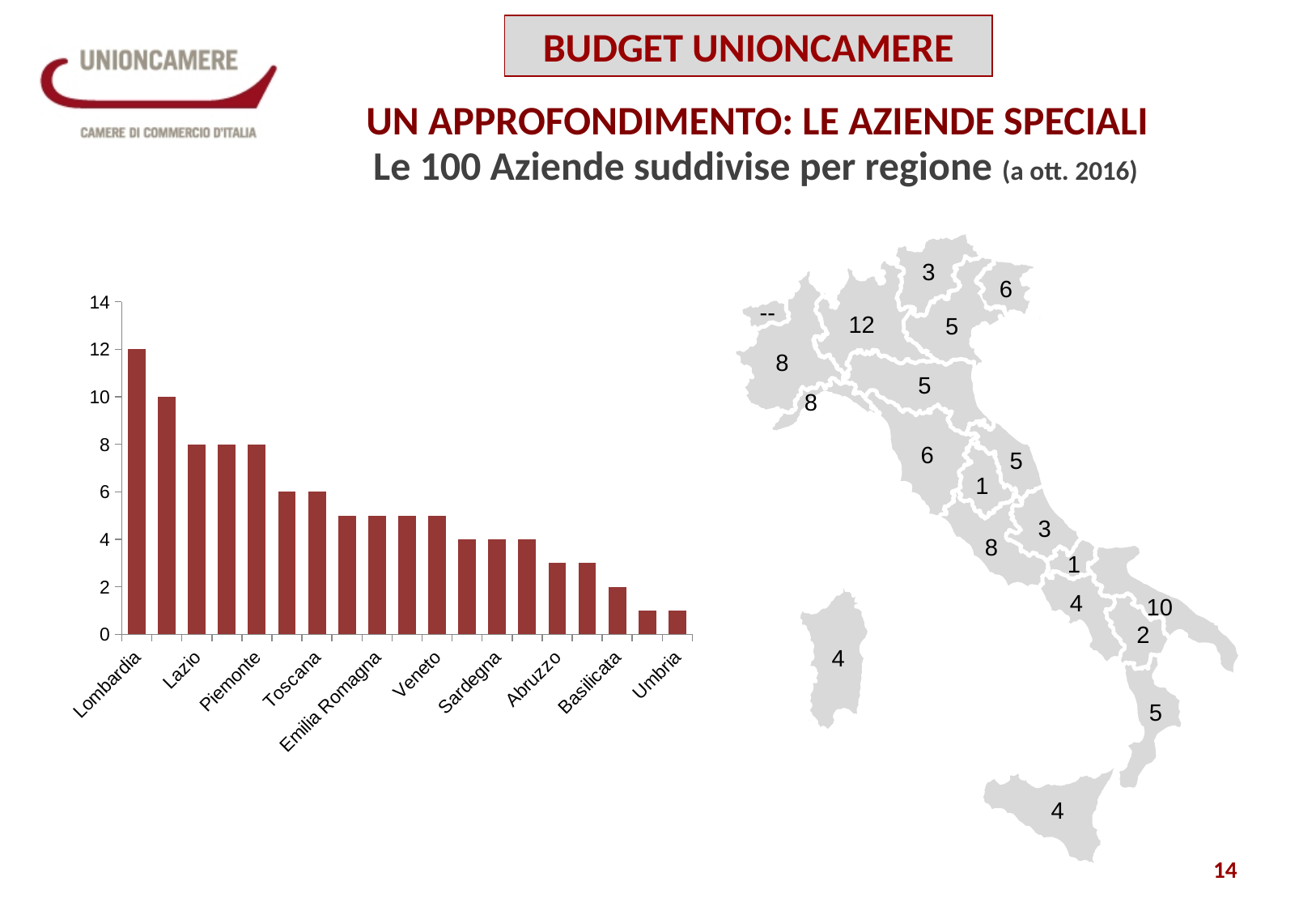
In the bar chart, what is the value for Basilicata? 2 In the bar chart, what is the difference between the values for Lombardia and Lazio? 4 In the bar chart, is the value for Umbria greater or less than 2? less In the bar chart, what is the value for Toscana? 6 In the bar chart, what is the value for Sardegna? 4 In the bar chart, which region has the highest value? Lombardia In the bar chart, which is larger, the value for Lombardia or the value for Piemonte? Lombardia In the bar chart, what is the value for Lazio? 8 In the bar chart, do the values rise or fall from left to right along the x axis? fall In the bar chart, is the value for Emilia Romagna greater or less than 4? greater In the bar chart, what is the value for Lombardia? 12 What type of chart is shown on the left of the slide? bar chart